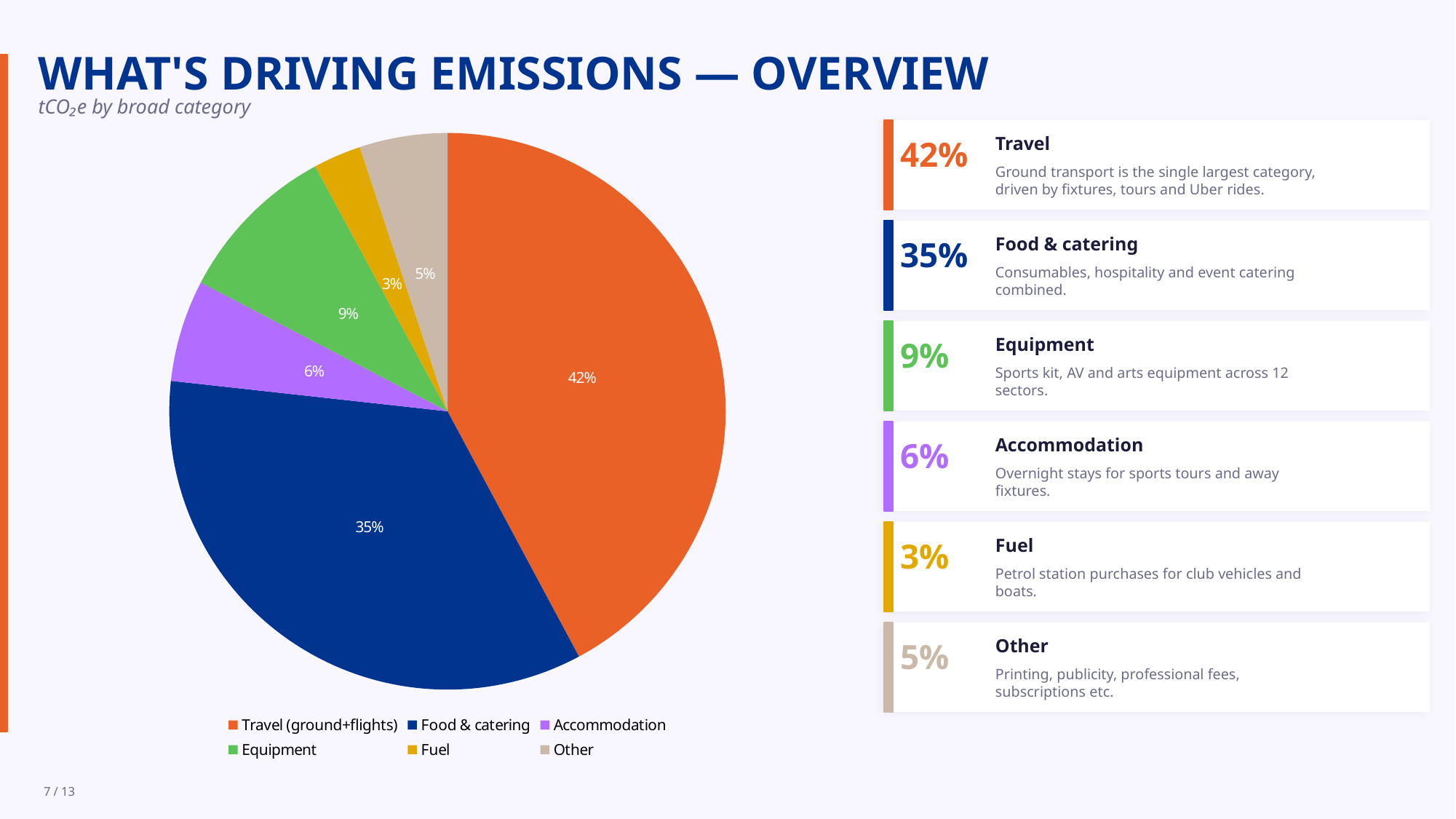
What is the combined share of Fuel and Other? 8% How many categories are shown in the pie chart? 6 What is the value shown for Equipment? 9% Which category has the smallest slice of the pie? Fuel What share of the pie does Travel (ground+flights) account for? 42% What is the value shown for Food & catering? 35% What kind of chart is shown on the slide? Pie chart What is the value shown for Accommodation? 6% Which is larger, the Equipment slice or the Other slice? Equipment Which category has the largest slice of the pie? Travel (ground+flights) What is the difference in percentage points between Travel (ground+flights) and Food & catering? 7 What colour is the Food & catering slice in the pie chart? Dark blue